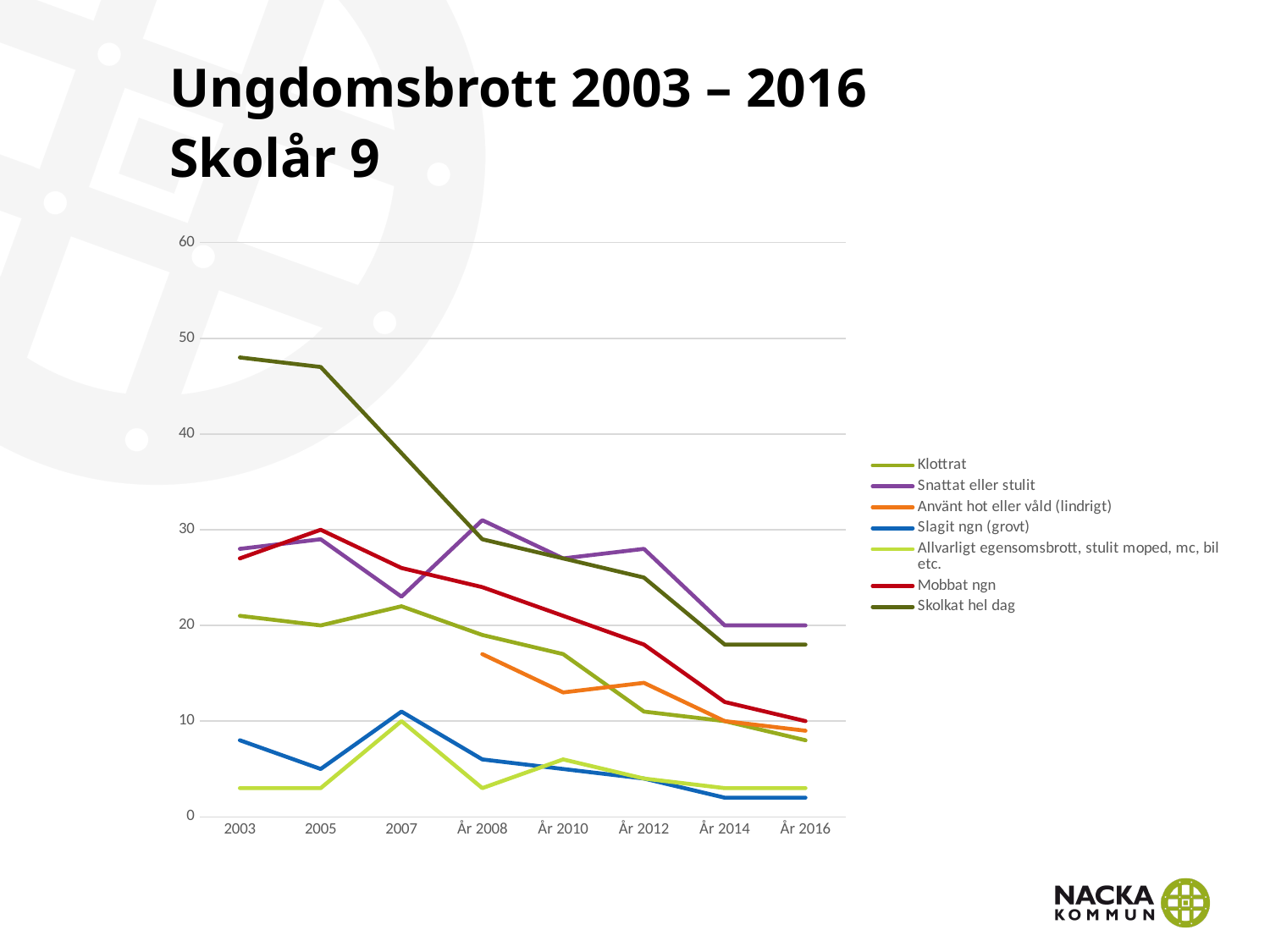
What kind of chart is shown on the slide? line chart In 2003, which is larger: the value for Skolkat hel dag or the value for Klottrat? Skolkat hel dag How many points are there along the x axis? 8 Is the value for Allvarligt egensomsbrott, stulit moped, mc, bil etc. in 2003 greater or less than 10? less How many series does the legend list? 7 Which series has the highest value in 2003? Skolkat hel dag Does the value for Skolkat hel dag rise or fall from 2003 to År 2016? fall What is the title of the slide? Ungdomsbrott 2003 – 2016 Skolår 9 Is the value for Skolkat hel dag in 2003 greater or less than 40? greater What is the value for Snattat eller stulit in År 2016? 20 Is the value for Slagit ngn (grovt) in 2003 greater or less than 10? less